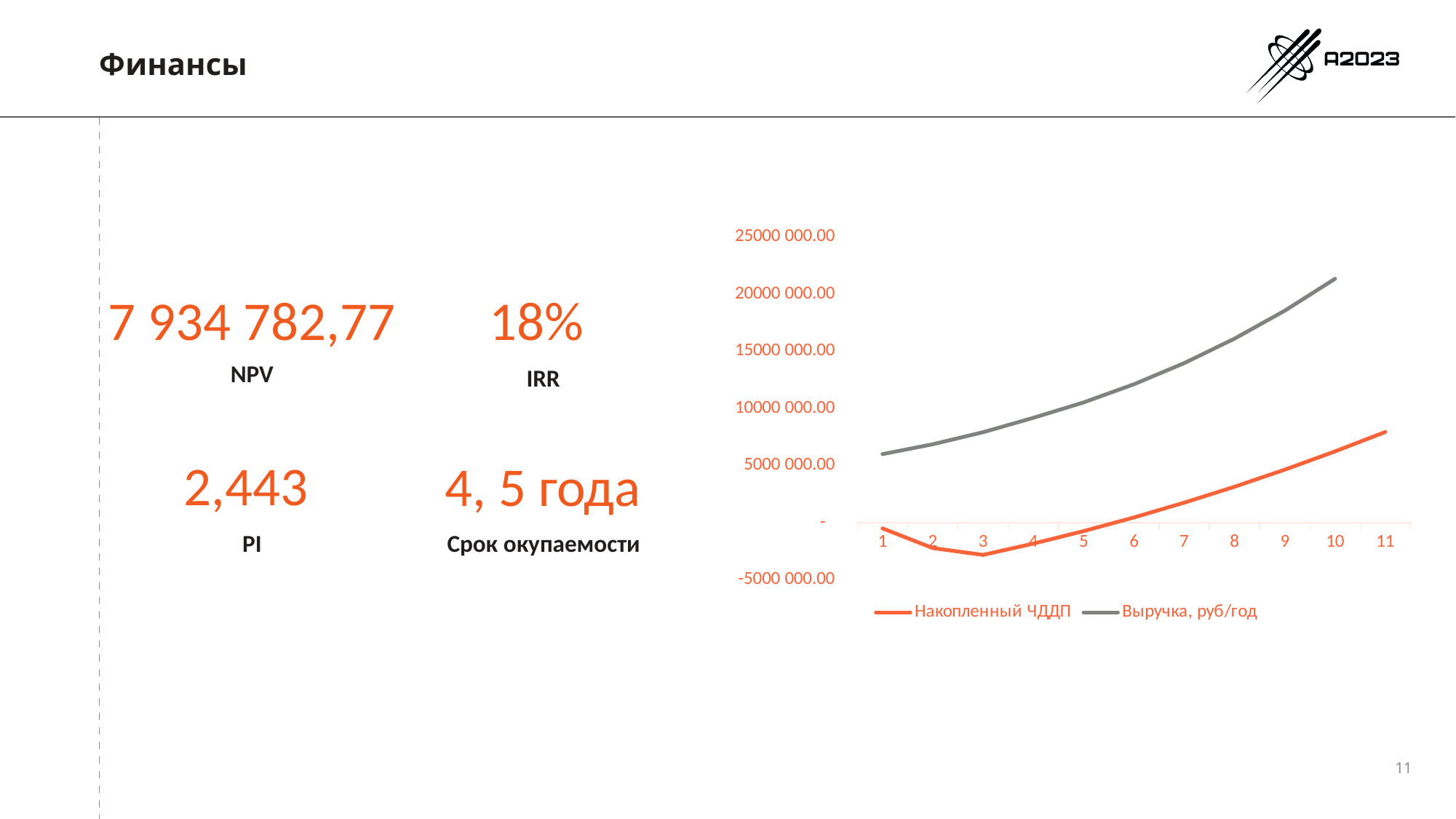
Is the value of Выручка, руб/год at point 7 greater or less than 10000 000.00? greater What are the two series named in the chart legend? Накопленный ЧДДП and Выручка, руб/год What colour is the line for Выручка, руб/год? grey How many series does the chart legend list? 2 How many points are labelled on the x axis of the chart? 11 Does the Выручка, руб/год line rise or fall along the x axis? rises What kind of chart is shown on the slide? line chart Is the value of Выручка, руб/год at point 1 greater or less than 5000 000.00? greater At which x-axis point does the Накопленный ЧДДП line reach its lowest value? 3 Is the value of Накопленный ЧДДП at point 3 greater or less than 0? less At which x-axis point does the Выручка, руб/год line reach its highest value? 10 At point 5, which series has the higher value, Накопленный ЧДДП or Выручка, руб/год? Выручка, руб/год